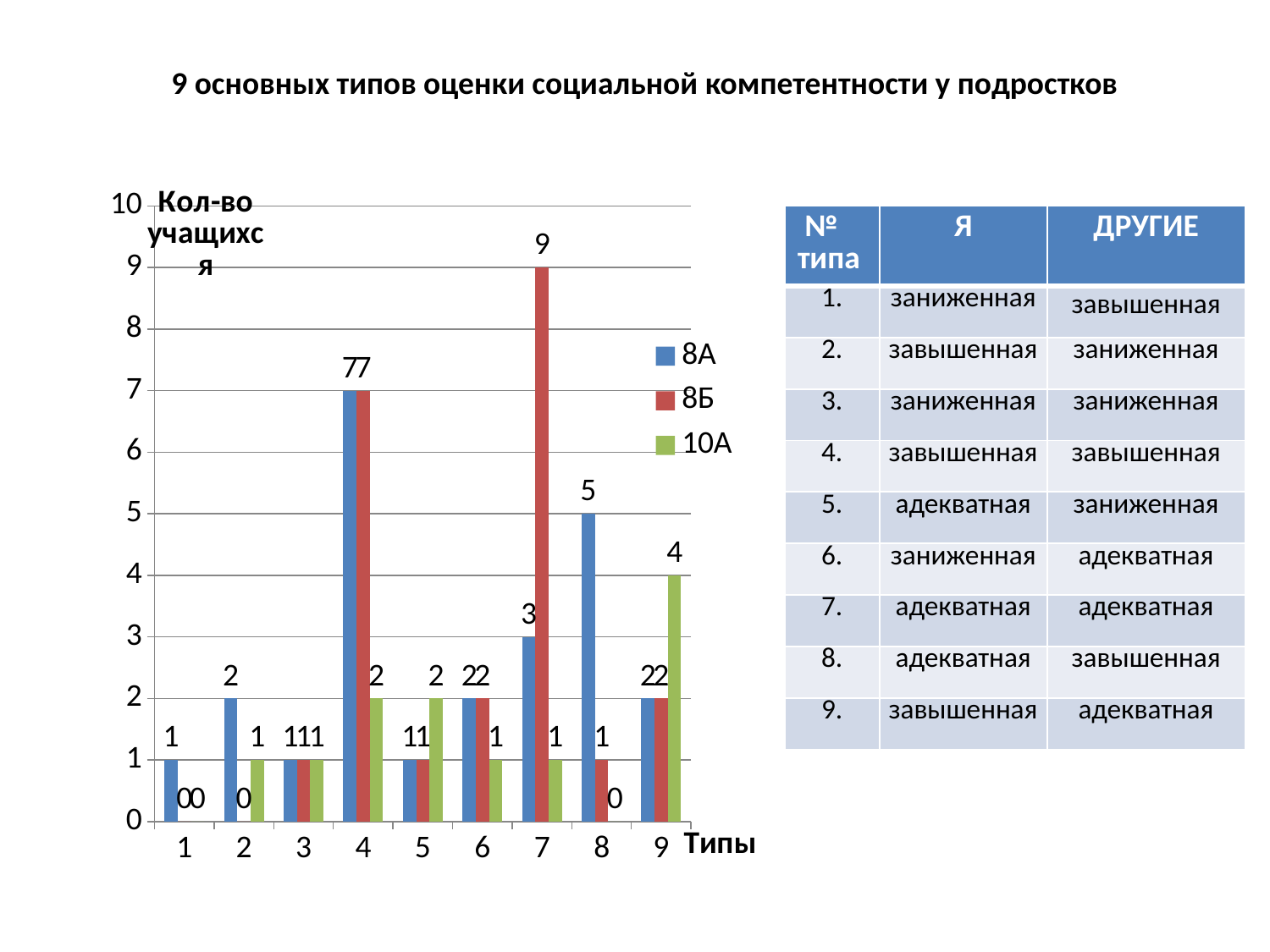
What is the value for series 8А at type 8? 5 What is the value for series 8Б at type 7? 9 What is the value for series 10А at type 9? 4 At type 8, which series has the larger value, 8А or 8Б? 8А Which series is shown in green in the chart legend? 10А For series 10А, which type has the highest value? 9 How many types (categories) are shown on the x axis of the chart? 9 What is the difference between the 8Б value and the 8А value at type 7? 6 What kind of chart is shown on the slide? bar chart How many series does the chart legend list? 3 What is the value for series 8А at type 4? 7 For series 8Б, which type has the highest value? 7